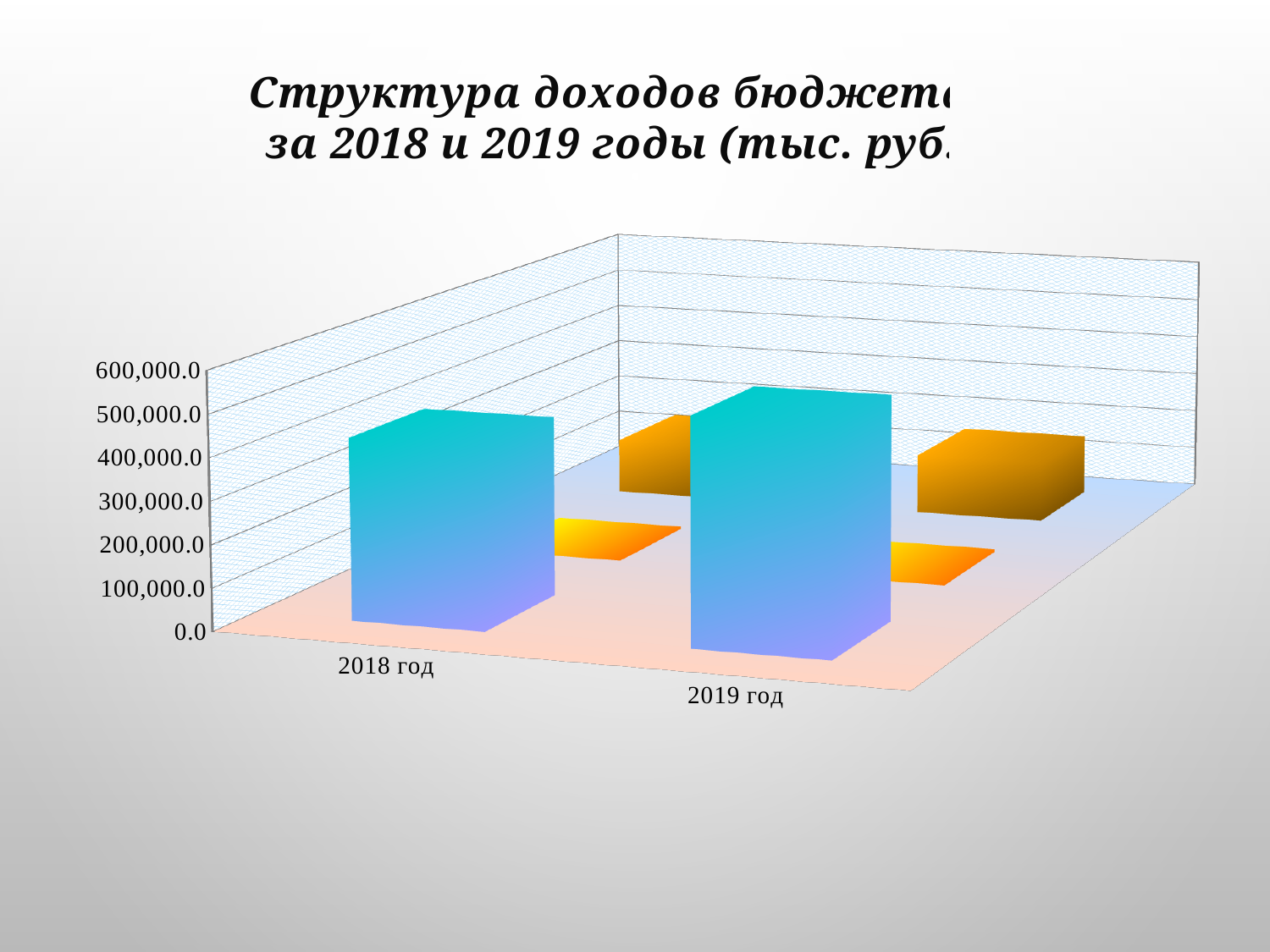
Is the value of the yellow bar for 2018 год greater or less than 300,000.0? less Is the value of the blue bar for 2018 год greater or less than 200,000.0? greater Do the blue bars rise or fall from 2018 год to 2019 год? rise What unit is given in the chart title? тыс. руб. Which bar is the tallest on the whole chart? the blue bar for 2019 год Is the value of the yellow bar for 2019 год greater or less than 300,000.0? less What kind of chart is shown on the slide? bar chart Within 2018 год, which bar is taller, the blue one or the yellow one? the blue one Which year has the taller blue bar, 2018 год or 2019 год? 2019 год What is the highest value shown on the vertical axis? 600,000.0 How many year categories are shown on the x axis? 2